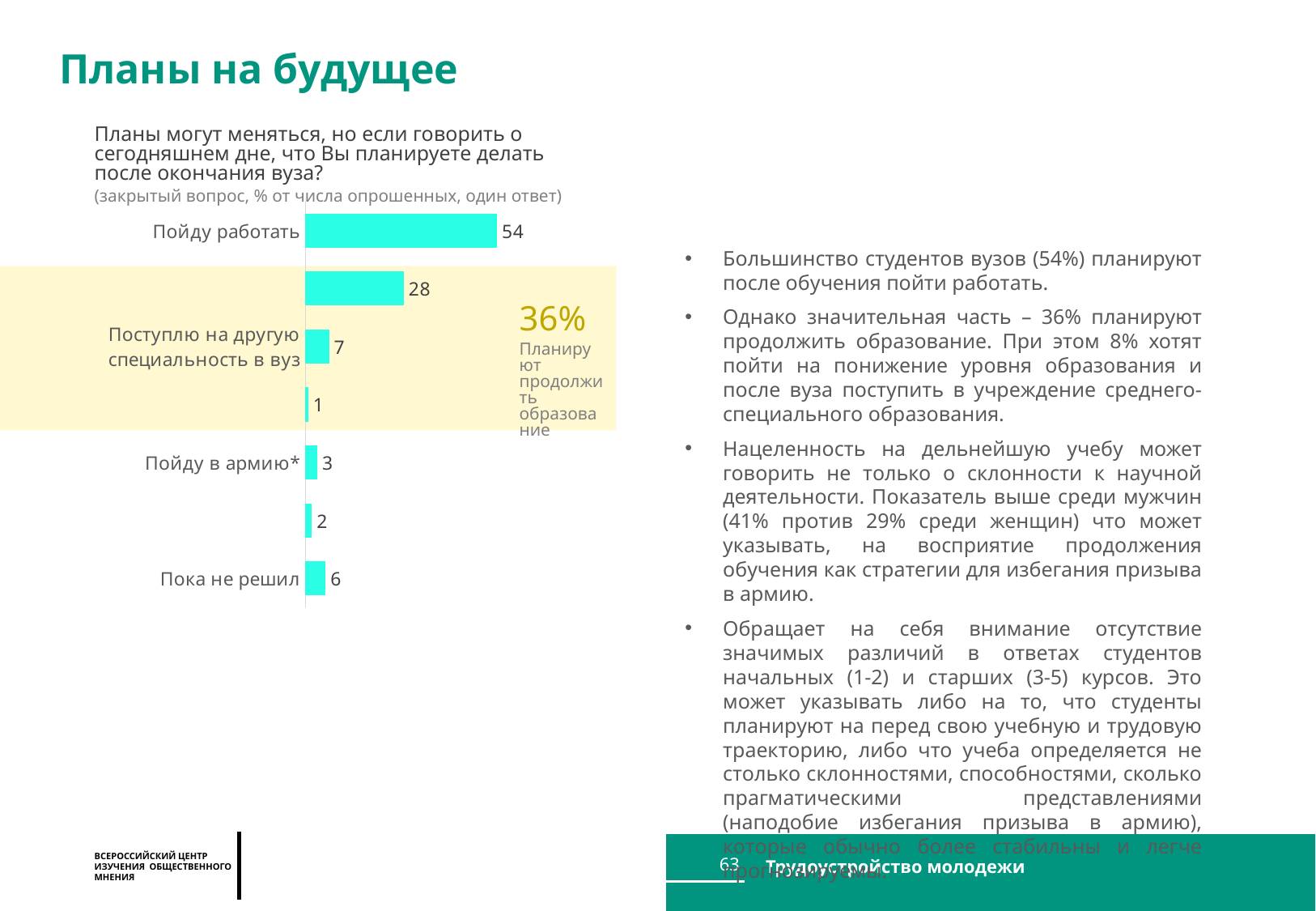
What is the value for "Поступлю на другую специальность в вуз"? 7 What is the value for "Пойду в армию*"? 3 What percentage is highlighted in the yellow callout next to the chart? 36% What is the largest value shown in the chart? 54 Which category has the highest value in the chart? Пойду работать How many bars are plotted in the chart? 7 What kind of chart is shown on the slide? bar chart What is the value for "Пока не решил"? 6 Which is larger: the value for "Пока не решил" or the value for "Пойду в армию*"? Пока не решил What is the value for "Пойду работать"? 54 What is the difference between the values for "Пойду работать" and "Пока не решил"? 48 What is the difference between the values for "Поступлю на другую специальность в вуз" and "Пойду в армию*"? 4